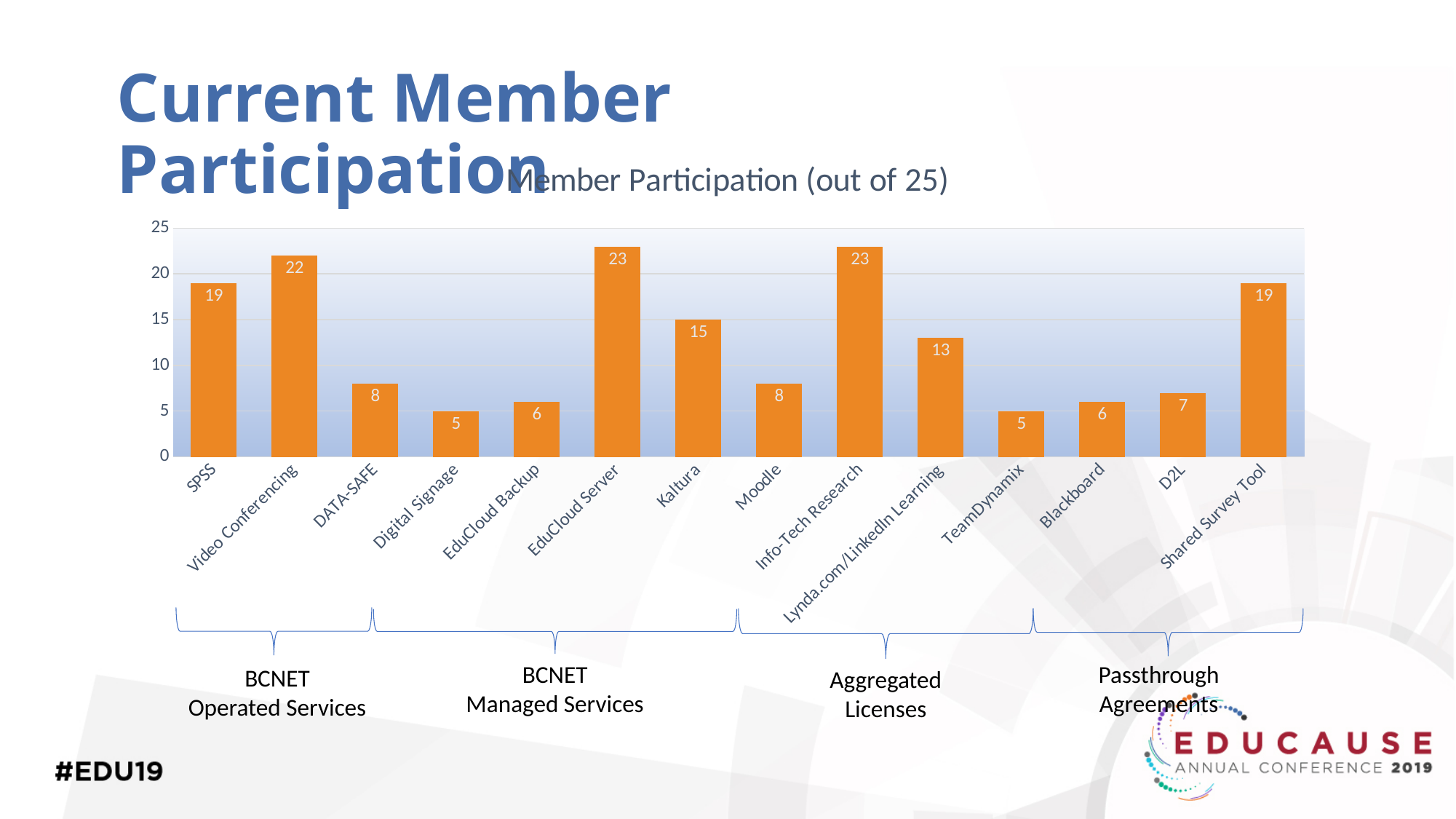
What is the highest value shown on the chart? 23 What is the value for Kaltura? 15 What is the value for Lynda.com/LinkedIn Learning? 13 What is the lowest value shown on the chart? 5 What is the title of the chart? Member Participation (out of 25) How many categories are shown on the chart? 14 What is the value for Shared Survey Tool? 19 What is the value for Video Conferencing? 22 Which has a larger value, SPSS or DATA-SAFE? SPSS What is the difference between the values for EduCloud Server and EduCloud Backup? 17 What kind of chart is shown on the slide? bar chart Is the value for Moodle greater or less than 10? less